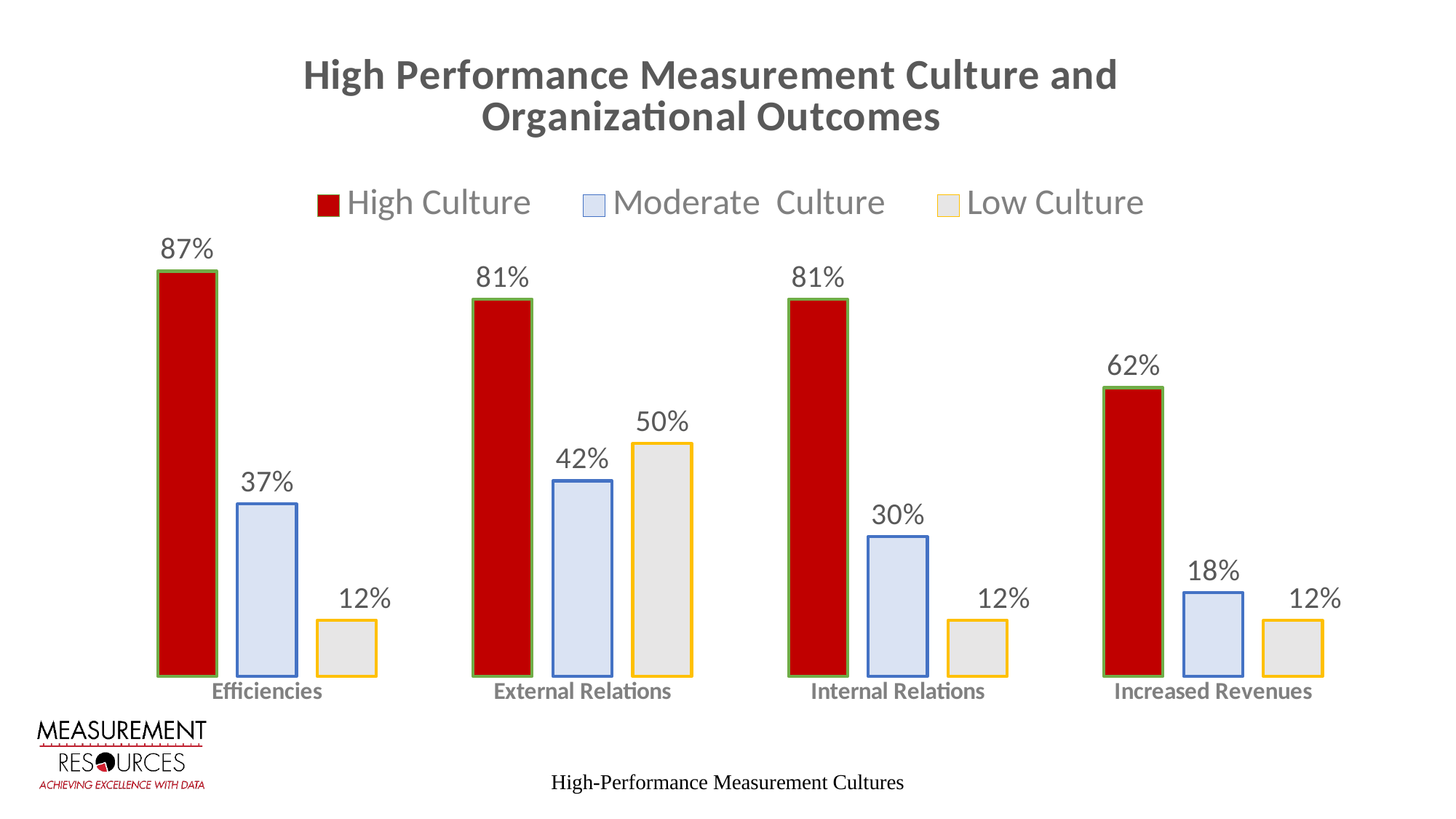
What kind of chart is shown on the slide? Bar chart What is the Low Culture value for External Relations? 50% What is the High Culture value for Efficiencies? 87% What is the High Culture value for Increased Revenues? 62% Which category has the highest High Culture value? Efficiencies Which category has the lowest Moderate Culture value? Increased Revenues How many series does the legend list? 3 How many categories are shown on the x axis? 4 What is the title of the chart? High Performance Measurement Culture and Organizational Outcomes What is the Moderate Culture value for Internal Relations? 30% What is the difference between the High Culture and Moderate Culture values for Efficiencies? 50% Which is larger for External Relations: the Moderate Culture value or the Low Culture value? Low Culture